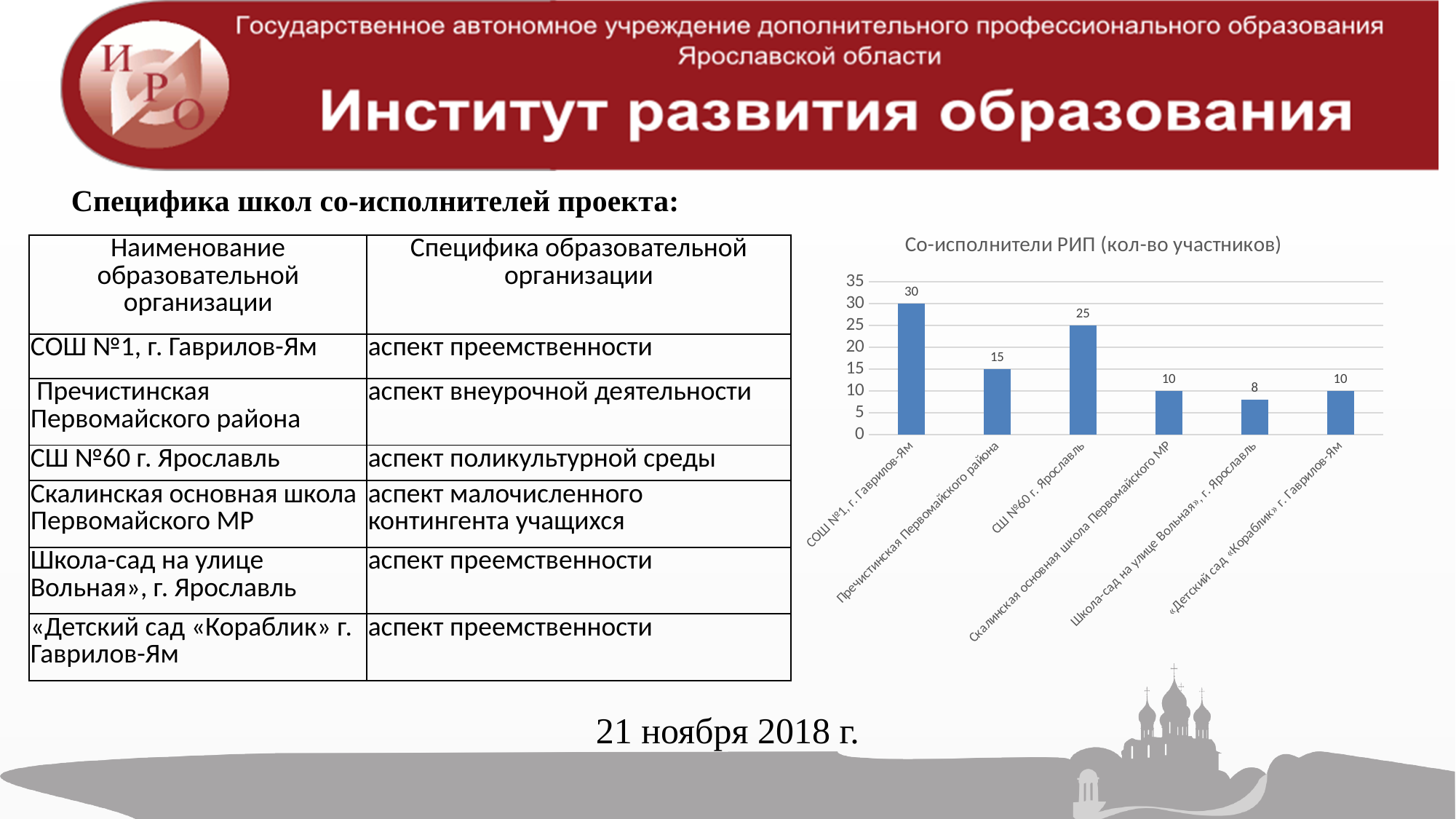
Is the value for СШ №60 г. Ярославль greater or less than 20? greater What is the value for СОШ №1, г. Гаврилов-Ям in the chart? 30 Which category has the highest value in the chart? СОШ №1, г. Гаврилов-Ям What is the value for Пречистинская Первомайского района in the chart? 15 How many categories are shown in the chart? 6 Which category has the lowest value in the chart? Школа-сад на улице Вольная», г. Ярославль Which is larger: the value for Пречистинская Первомайского района or the value for Скалинская основная школа Первомайского МР? Пречистинская Первомайского района What is the value for Школа-сад на улице Вольная», г. Ярославль in the chart? 8 What is the value for СШ №60 г. Ярославль in the chart? 25 What kind of chart is shown on the slide? bar chart What is the difference between the values for СОШ №1, г. Гаврилов-Ям and СШ №60 г. Ярославль? 5 What is the title of the chart? Со-исполнители РИП (кол-во участников)